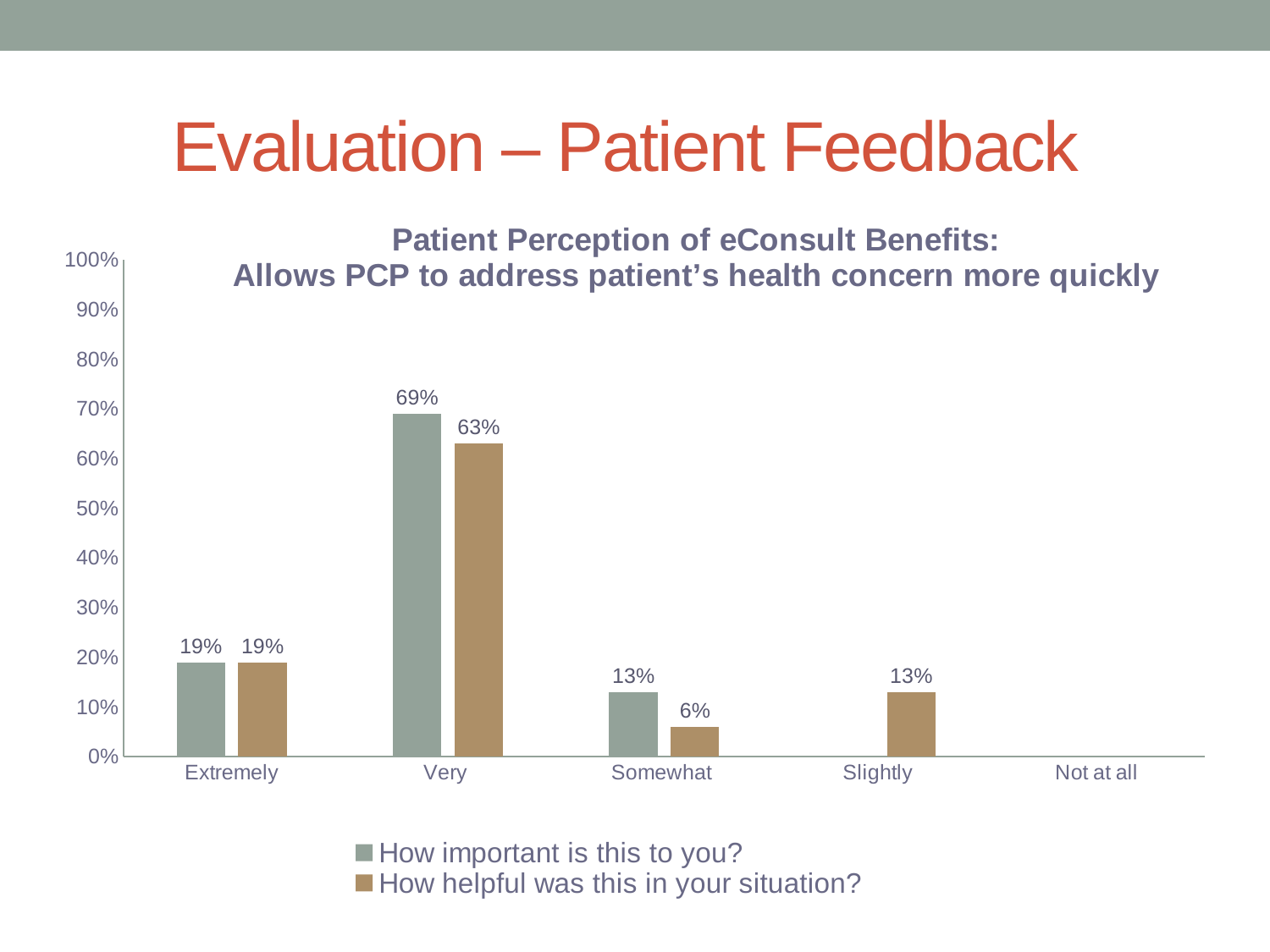
What is the value for "Extremely" in the "How important is this to you?" series? 19% How many series does the legend list? 2 Is the value for "Very" in the "How helpful was this in your situation?" series greater or less than 50%? greater What is the value for "Somewhat" in the "How helpful was this in your situation?" series? 6% Which category has the highest value in the "How important is this to you?" series? Very What is the difference between the two series' values for "Very"? 6% What is the title of the chart? Patient Perception of eConsult Benefits: Allows PCP to address patient's health concern more quickly How many categories are shown on the x axis? 5 What is the value for "Very" in the "How important is this to you?" series? 69% What is the value for "Slightly" in the "How helpful was this in your situation?" series? 13% For "Somewhat", which series has the larger value? How important is this to you? What kind of chart is shown on the slide? Bar chart